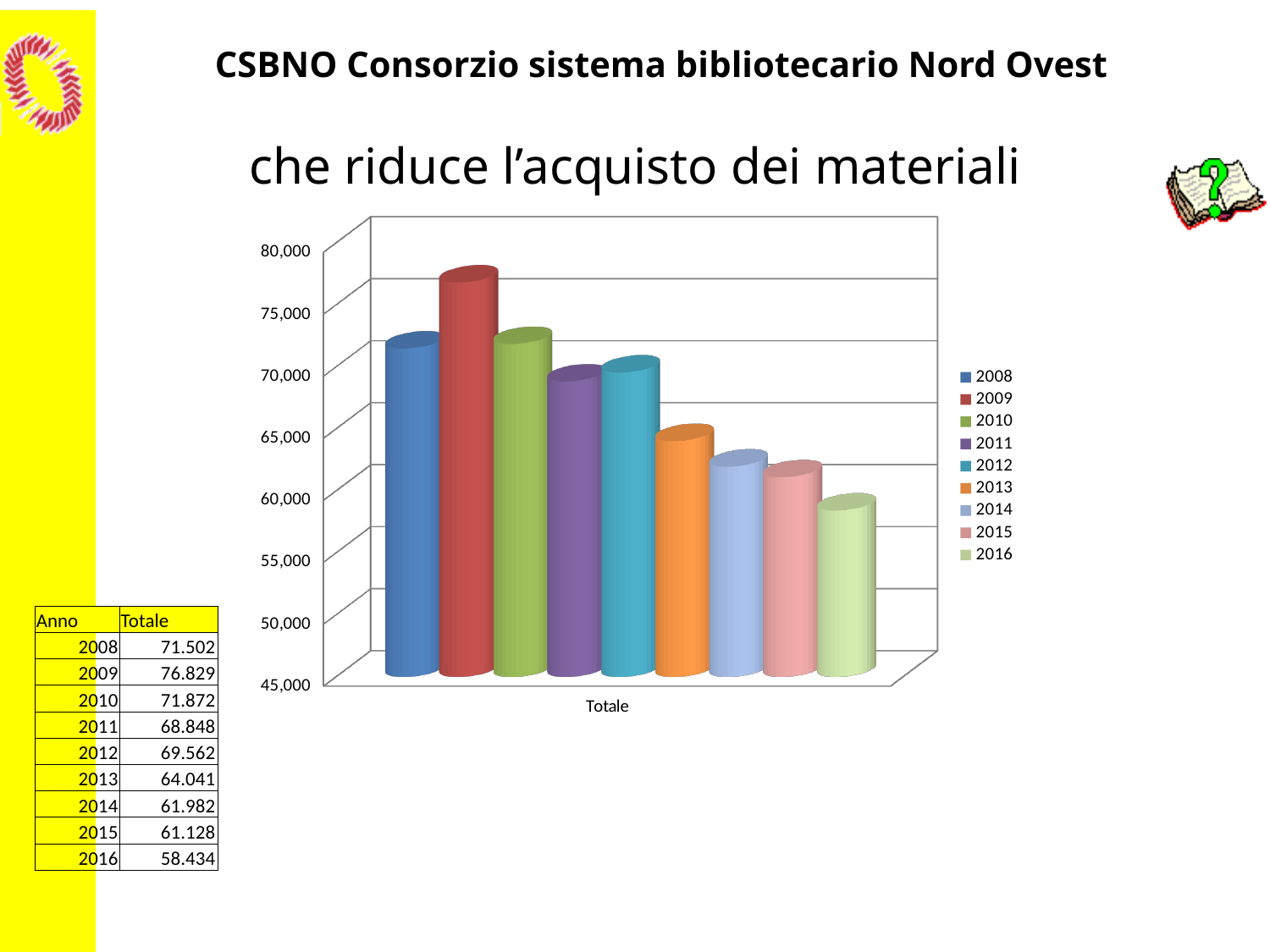
What kind of chart is shown on the slide? bar chart Do the values generally rise or fall from 2009 to 2016? fall Which is larger, the value for 2009 or the value for 2013? 2009 Is the value for 2014 greater or less than 60,000? greater Is the value for 2008 greater or less than 70,000? greater Is the value for 2016 greater or less than 60,000? less What is the category label shown on the x axis of the chart? Totale How many series does the chart legend list? 9 According to the table on the slide, what is the Totale for 2016? 58.434 Which year has the highest bar in the chart? 2009 Which year has the lowest bar in the chart? 2016